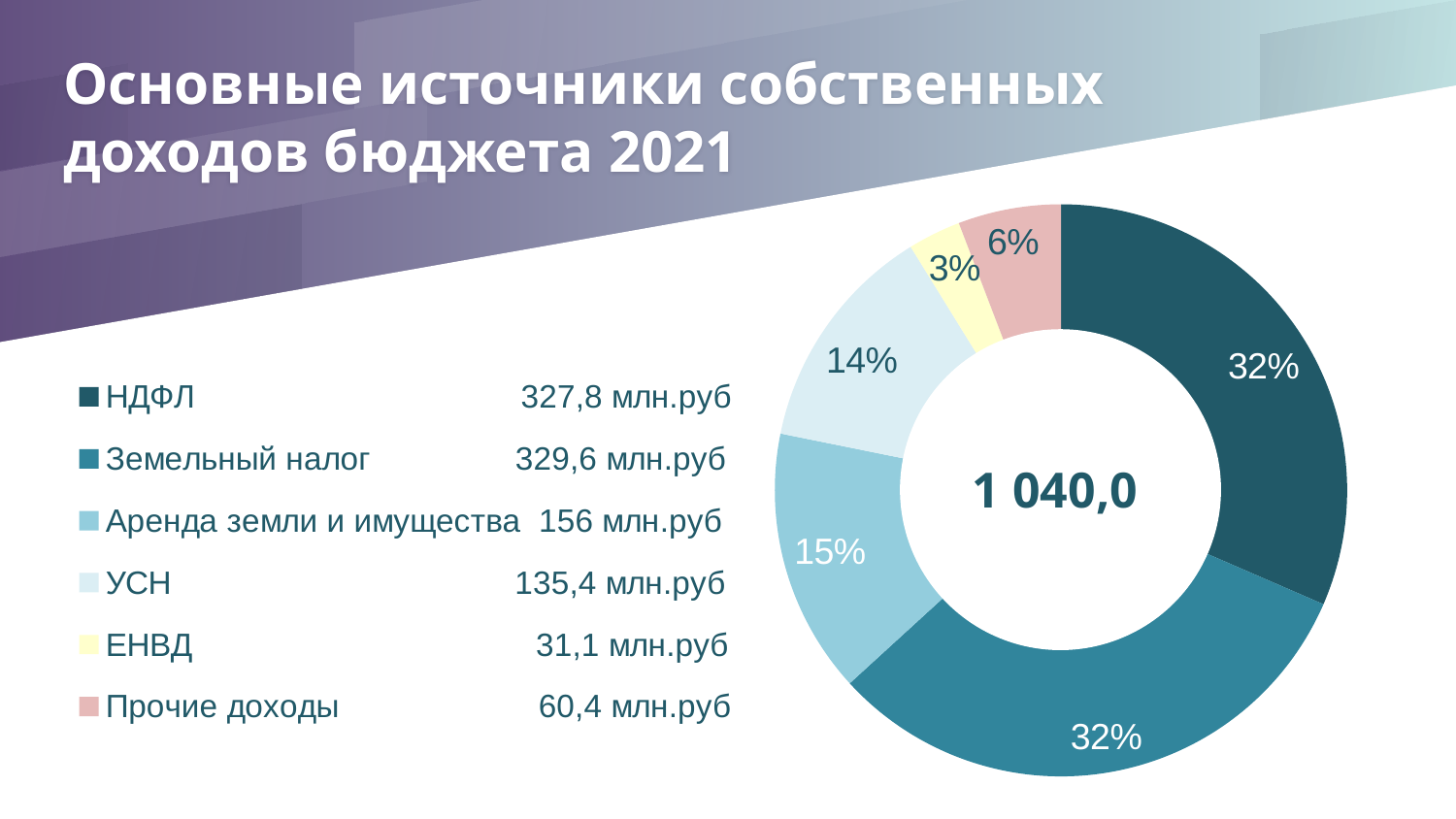
Which category has the highest value according to the legend figures? Земельный налог What kind of chart is shown on the slide? Pie (donut) chart How many categories are shown in the chart? 6 What is the value for НДФЛ? 327,8 млн.руб What share of the chart does ЕНВД represent? 3% What is the difference between Аренда земли и имущества and УСН? 20,6 млн.руб What is the value for Аренда земли и имущества? 156 млн.руб What share of the chart does УСН represent? 14% What is the value for Земельный налог? 329,6 млн.руб Which is larger, Прочие доходы or ЕНВД? Прочие доходы What is the value for УСН? 135,4 млн.руб Which category has the lowest value? ЕНВД